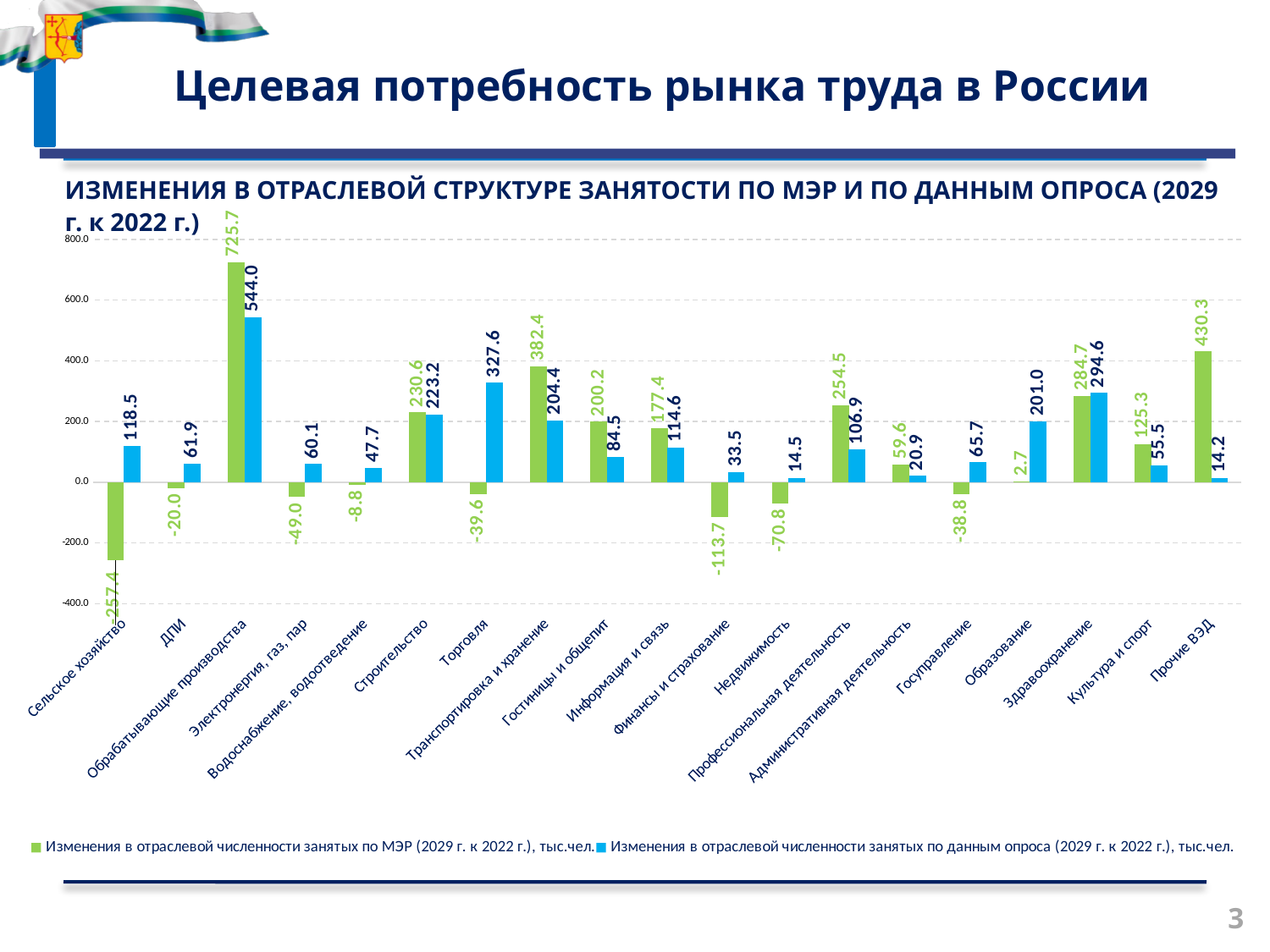
What is the value for Торговля in the series 'Изменения в отраслевой численности занятых по данным опроса (2029 г. к 2022 г.), тыс.чел.'? 327.6 What is the value for Обрабатывающие производства in the series 'Изменения в отраслевой численности занятых по МЭР (2029 г. к 2022 г.), тыс.чел.'? 725.7 What is the difference between the МЭР value and the опрос value for Прочие ВЭД? 416.1 How many series does the legend list? 2 Which category has the lowest value in the МЭР series? Сельское хозяйство Which category has the lowest value in the опрос series? Прочие ВЭД For Образование, which series has the larger value: МЭР or опрос? опрос Which category has the highest value in the МЭР series? Обрабатывающие производства What is the value for Сельское хозяйство in the МЭР series? -257.4 How many categories are shown on the x axis? 19 What colour represents the series 'Изменения в отраслевой численности занятых по данным опроса (2029 г. к 2022 г.), тыс.чел.'? blue What kind of chart is shown on the slide? bar chart